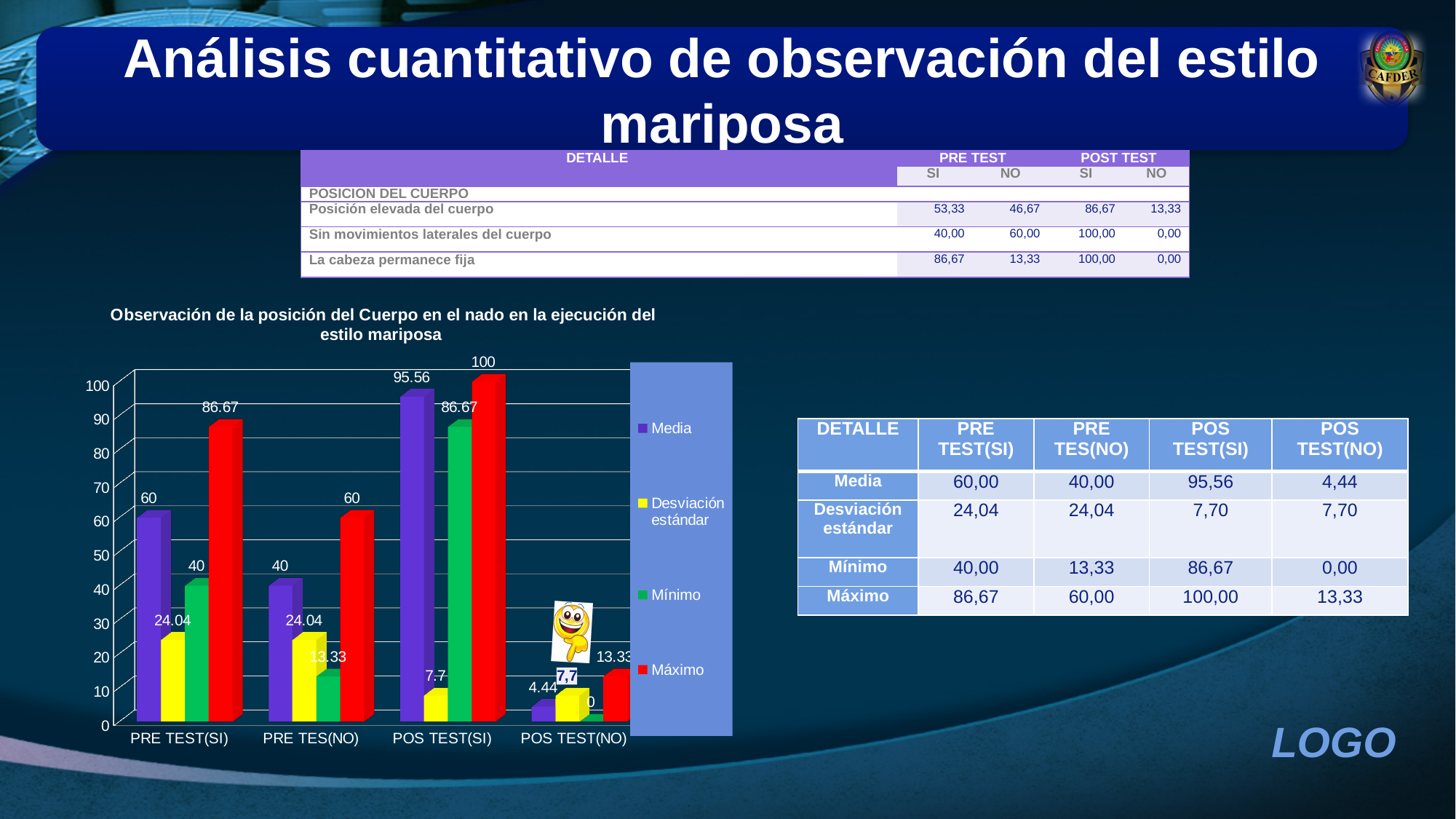
What is the Máximo value for POS TEST(SI) in the chart? 100 What is the difference between the Máximo and Mínimo values for PRE TEST(SI)? 46.67 How many categories are shown on the x axis of the chart? 4 What is the Media value for POS TEST(NO) in the chart? 4.44 What is the Mínimo value for POS TEST(SI) in the chart? 86.67 What is the Desviación estándar value for PRE TES(NO) in the chart? 24.04 How many series does the chart legend list? 4 What is the Media value for PRE TEST(SI) in the chart? 60 Which category has the highest Media value in the chart? POS TEST(SI) What type of chart is shown on the slide? bar chart Which category has the lowest Máximo value in the chart? POS TEST(NO) Is the Media value for PRE TEST(SI) larger or smaller than the Media value for PRE TES(NO)? larger